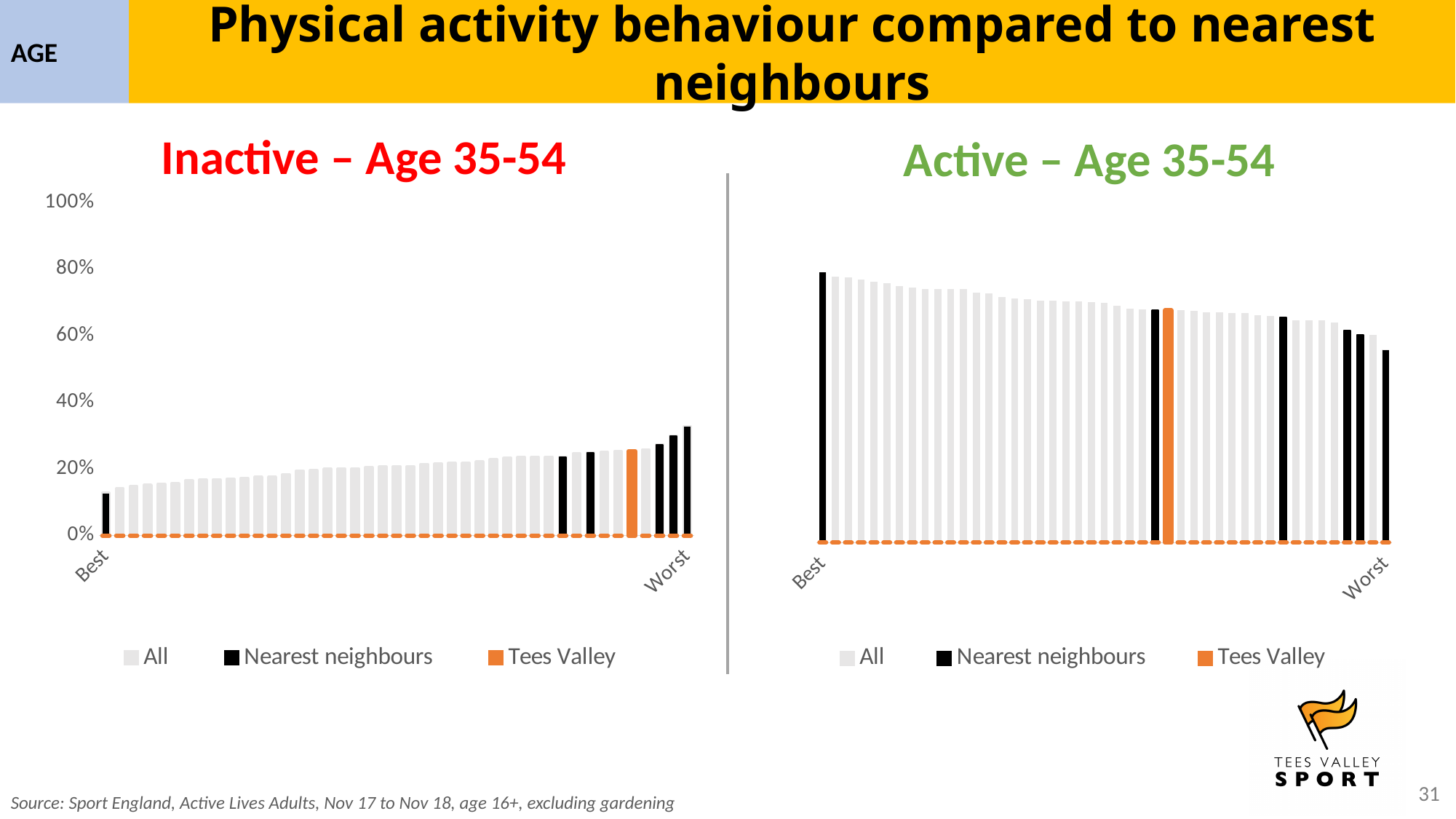
In the Active – Age 35-54 chart, is the value of the Worst bar greater or less than 40%? greater In the Inactive – Age 35-54 chart, is the value of the Best bar greater or less than 20%? less In the Inactive – Age 35-54 chart, is the value for Tees Valley greater or less than 20%? greater In the Inactive – Age 35-54 chart, do the bars rise or fall from Best to Worst along the x axis? rise What kind of chart is the Inactive – Age 35-54 chart? bar chart How many series does the legend of the Active – Age 35-54 chart list? 3 Which colour represents Tees Valley in the legend of the Inactive – Age 35-54 chart? orange In the Active – Age 35-54 chart, do the bars rise or fall from Best to Worst along the x axis? fall What are the two labels shown on the x axis of the Active – Age 35-54 chart? Best and Worst